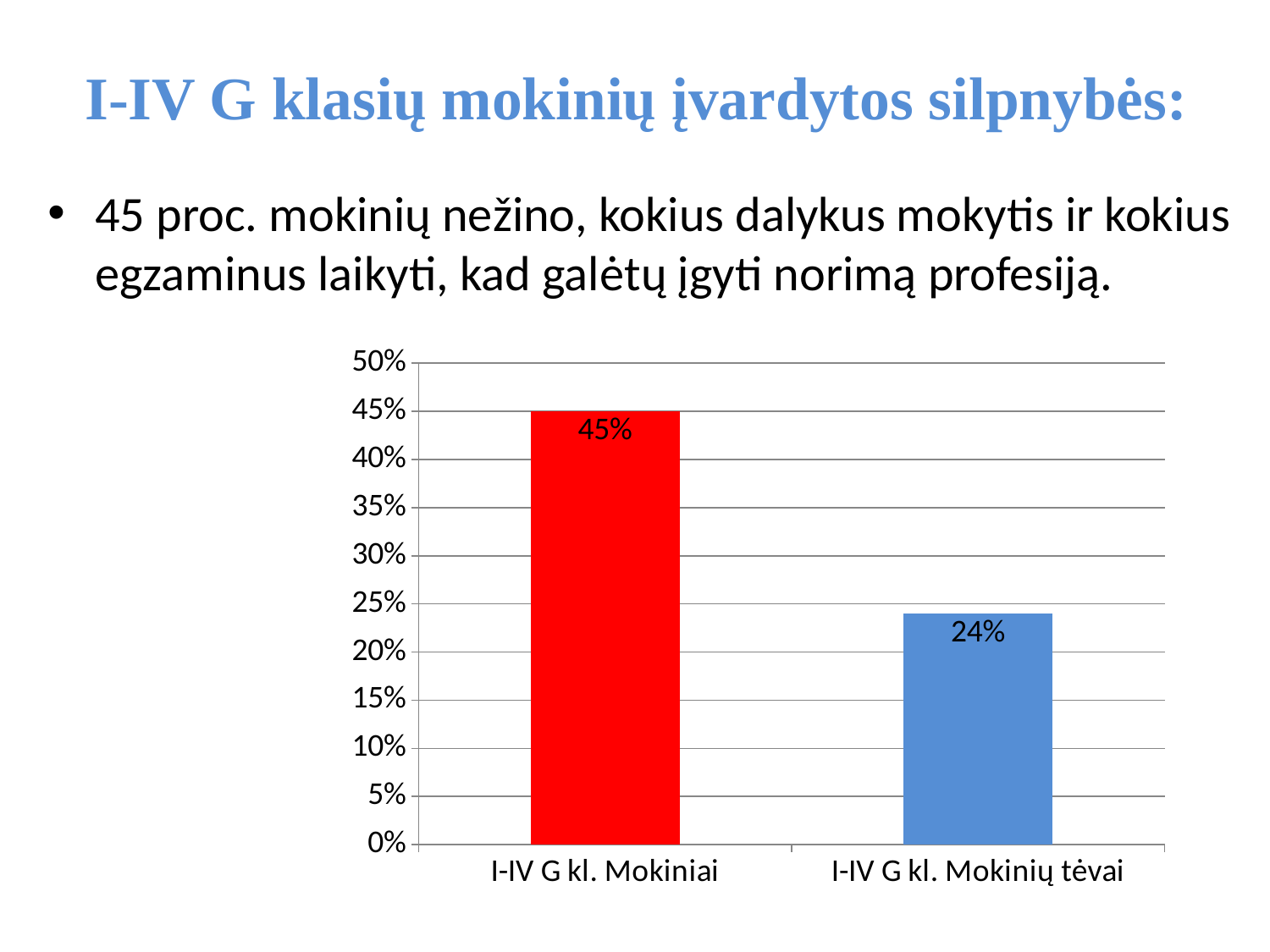
Which category has the lowest value? I-IV G kl. Mokinių tėvai What is the highest value shown on the vertical axis? 50% What is the difference between the values for I-IV G kl. Mokiniai and I-IV G kl. Mokinių tėvai? 21% Which category has the highest value? I-IV G kl. Mokiniai Is the value for I-IV G kl. Mokinių tėvai greater or less than 30%? less What colour is the bar for I-IV G kl. Mokiniai? red What kind of chart is shown on the slide? bar chart Which is larger, the value for I-IV G kl. Mokiniai or the value for I-IV G kl. Mokinių tėvai? I-IV G kl. Mokiniai How many categories are shown on the chart? 2 Is the value for I-IV G kl. Mokiniai greater or less than 40%? greater What is the value for I-IV G kl. Mokinių tėvai? 24% What is the value for I-IV G kl. Mokiniai? 45%